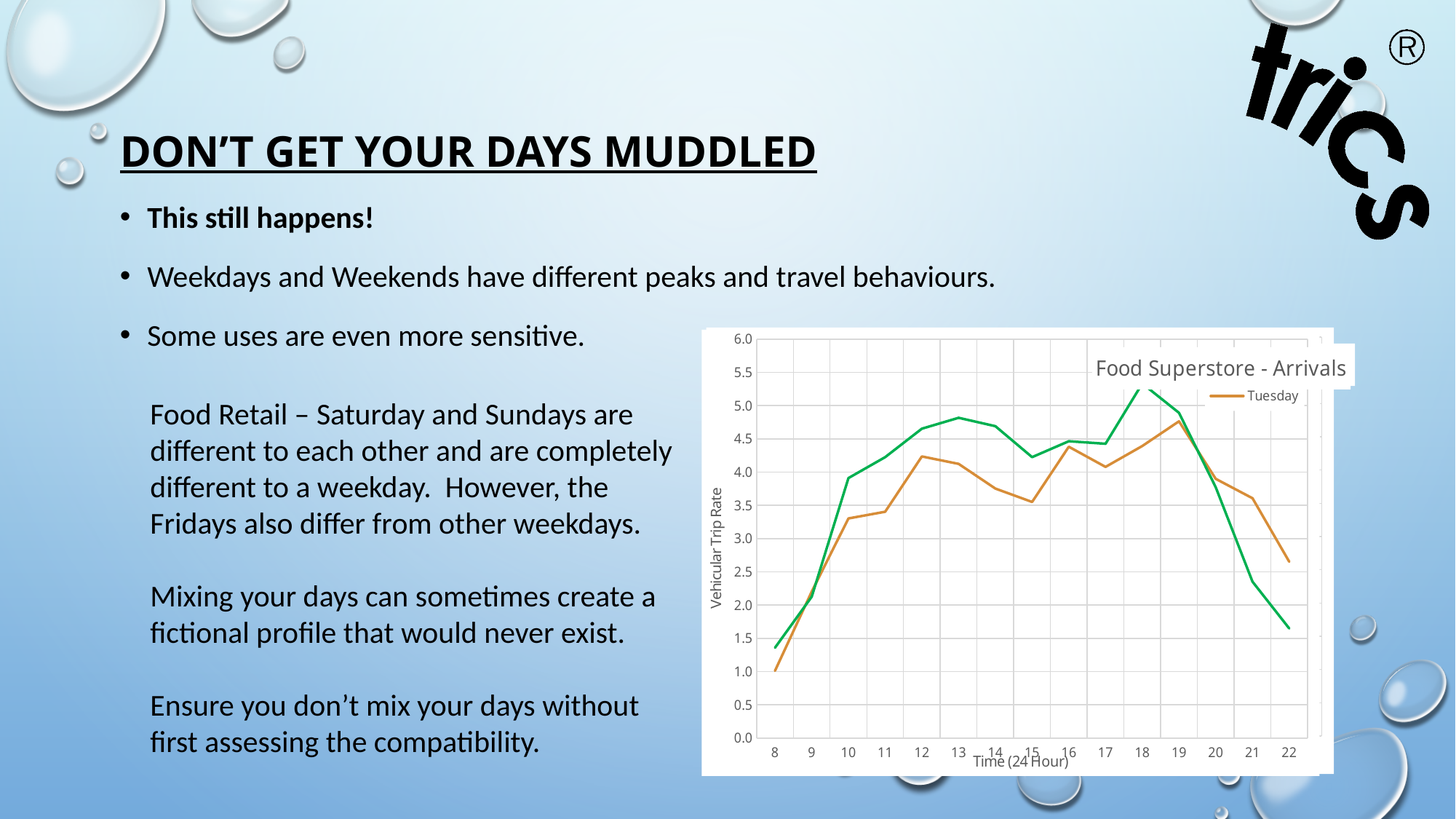
How many time points are plotted along the x axis of the chart? 15 Which series name is readable in the chart's legend? Tuesday At which hour does the Tuesday series reach its highest value? 19 What type of chart is shown on the slide? line chart Do the Tuesday values rise or fall between hour 19 and hour 22? fall At which hour does the Tuesday series have its lowest value? 8 Is the Tuesday value at hour 19 greater or less than 4.5? greater At hour 22, which series has the larger value, the Tuesday series or the green series? Tuesday Is the Tuesday value at hour 10 greater or less than 3.0? greater What is the title of the chart? Food Superstore - Arrivals Is the green series value at hour 22 greater or less than 2.0? less